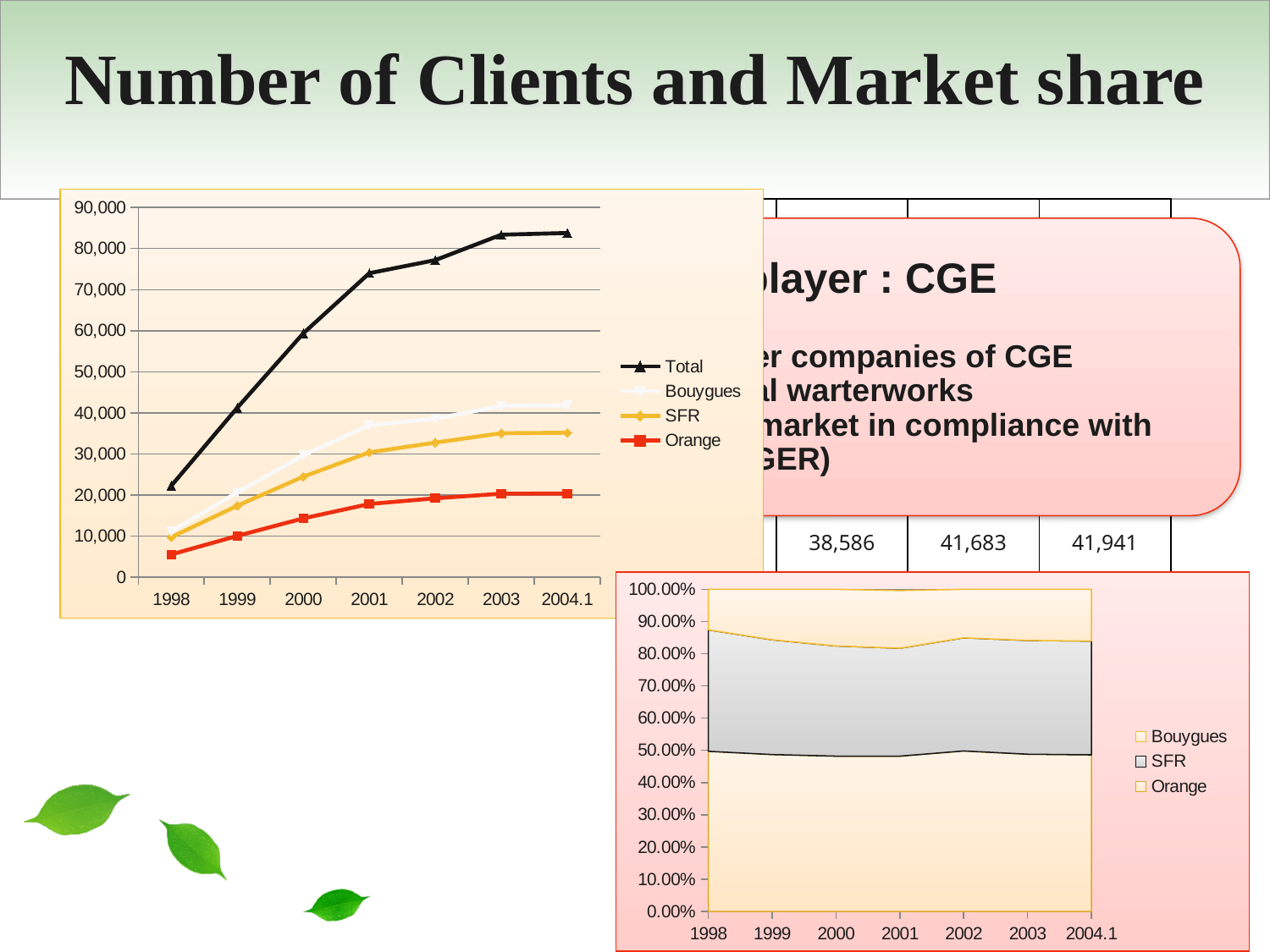
In the top-left line chart, is the Total value for 2004.1 greater or less than 80,000? greater In the top-left line chart, which is larger in 2004.1, Bouygues or SFR? Bouygues What kind of chart is the top-left chart showing the number of clients? line chart In the top-left line chart, how many years are shown on the x axis? 7 In the top-left line chart, does the Total series rise or fall from 1998 to 2004.1? rise In the top-left line chart, is the Total value for 2001 greater or less than 70,000? greater In the top-left line chart, how many series does the legend list? 4 In the bottom-right area chart, how many series does the legend list? 3 What kind of chart is the bottom-right chart showing market share percentages? area chart In the top-left line chart, is the Orange value for 1998 greater or less than 10,000? less In the bottom-right area chart, which series is listed first in the legend? Bouygues In the top-left line chart, which series has the lowest value in 2004.1? Orange